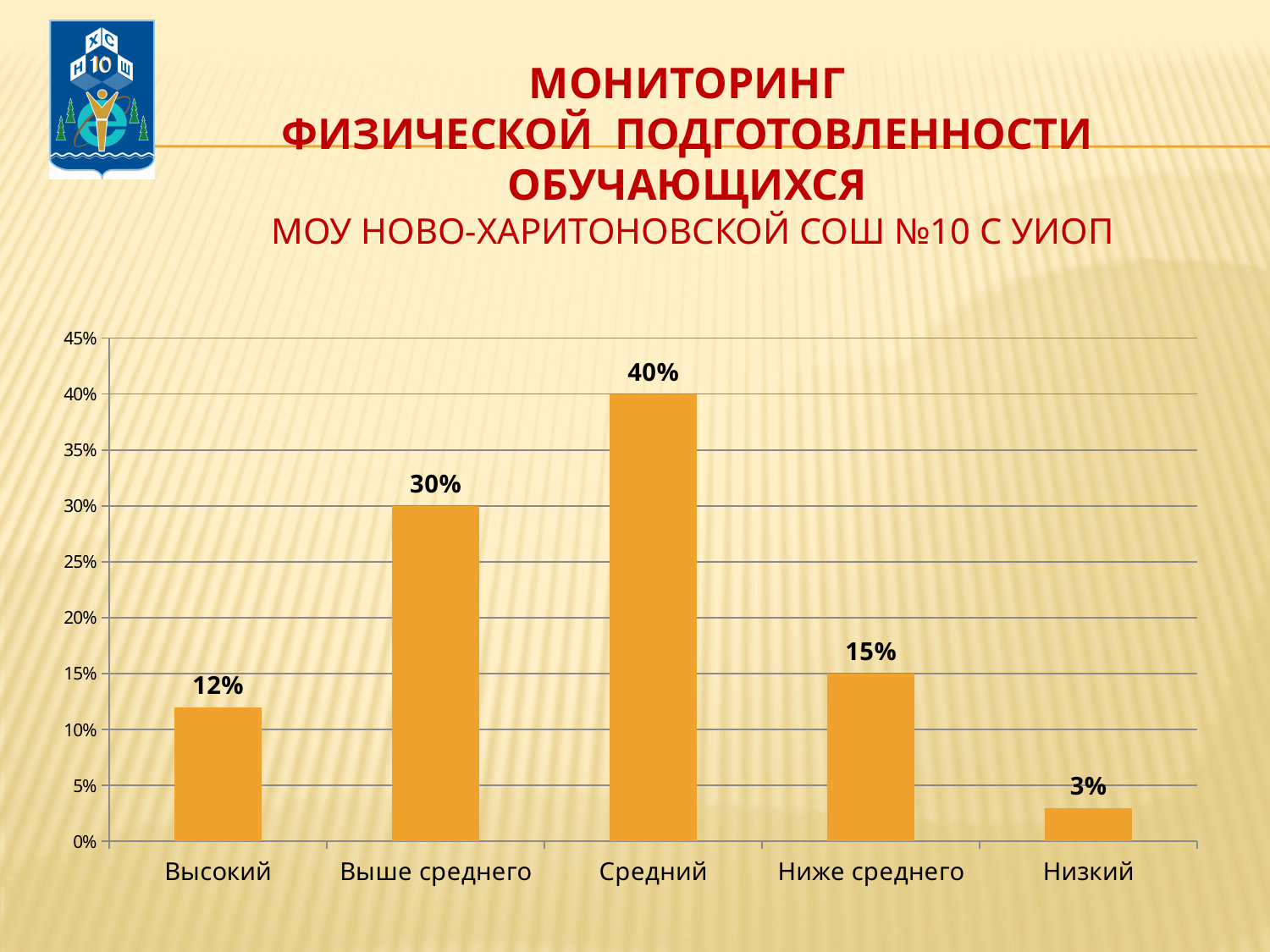
What is the difference between the values for Ниже среднего and Низкий? 12% Which is larger, the value for Выше среднего or the value for Ниже среднего? Выше среднего Which category has the lowest value? Низкий What is the value for Ниже среднего? 15% What is the value for Средний? 40% What is the value for Высокий? 12% What is the value for Низкий? 3% What is the highest value shown on the vertical axis? 45% How many categories are shown on the x axis? 5 What is the difference between the values for Средний and Выше среднего? 10% What kind of chart is shown on the slide? bar chart Which category has the highest value? Средний